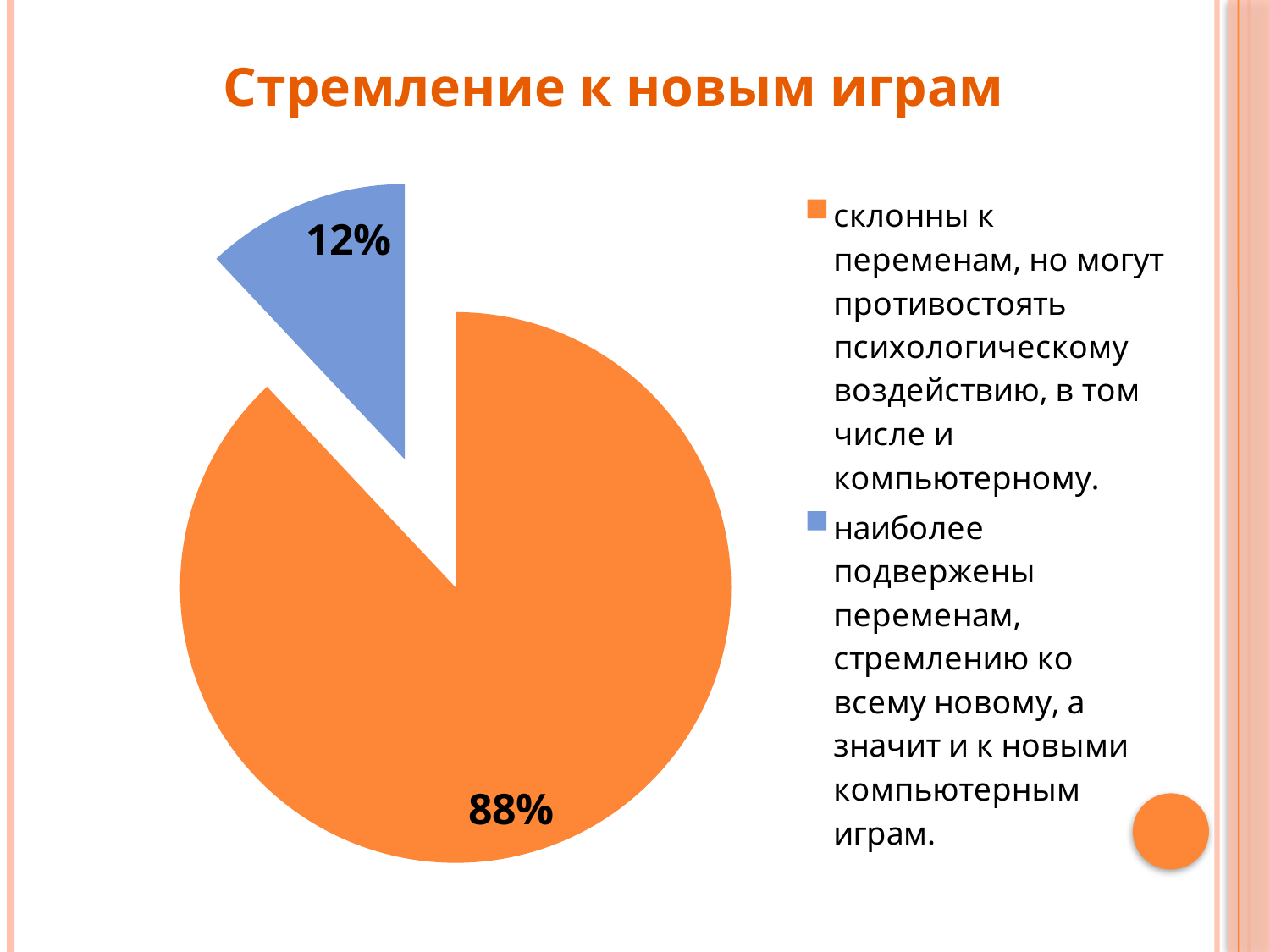
What share of the pie does the blue slice represent? 12% What is the difference in percentage points between the orange slice and the blue slice? 76 What is the value shown for the slice labelled 'склонны к переменам, но могут противостоять психологическому воздействию, в том числе и компьютерному'? 88% What is the value shown for the slice labelled 'наиболее подвержены переменам, стремлению ко всему новому, а значит и к новым компьютерным играм'? 12% How many slices does the pie chart have? 2 What colour is the slice labelled 12%? blue What is the title of the chart on the slide? Стремление к новым играм What share of the pie does the orange slice represent? 88% What kind of chart is shown on the slide? pie chart Which is larger: the orange slice or the blue slice? the orange slice Which slice is the largest in the pie chart? склонны к переменам, но могут противостоять психологическому воздействию, в том числе и компьютерному (88%) Which slice is the smallest in the pie chart? наиболее подвержены переменам, стремлению ко всему новому, а значит и к новым компьютерным играм (12%)